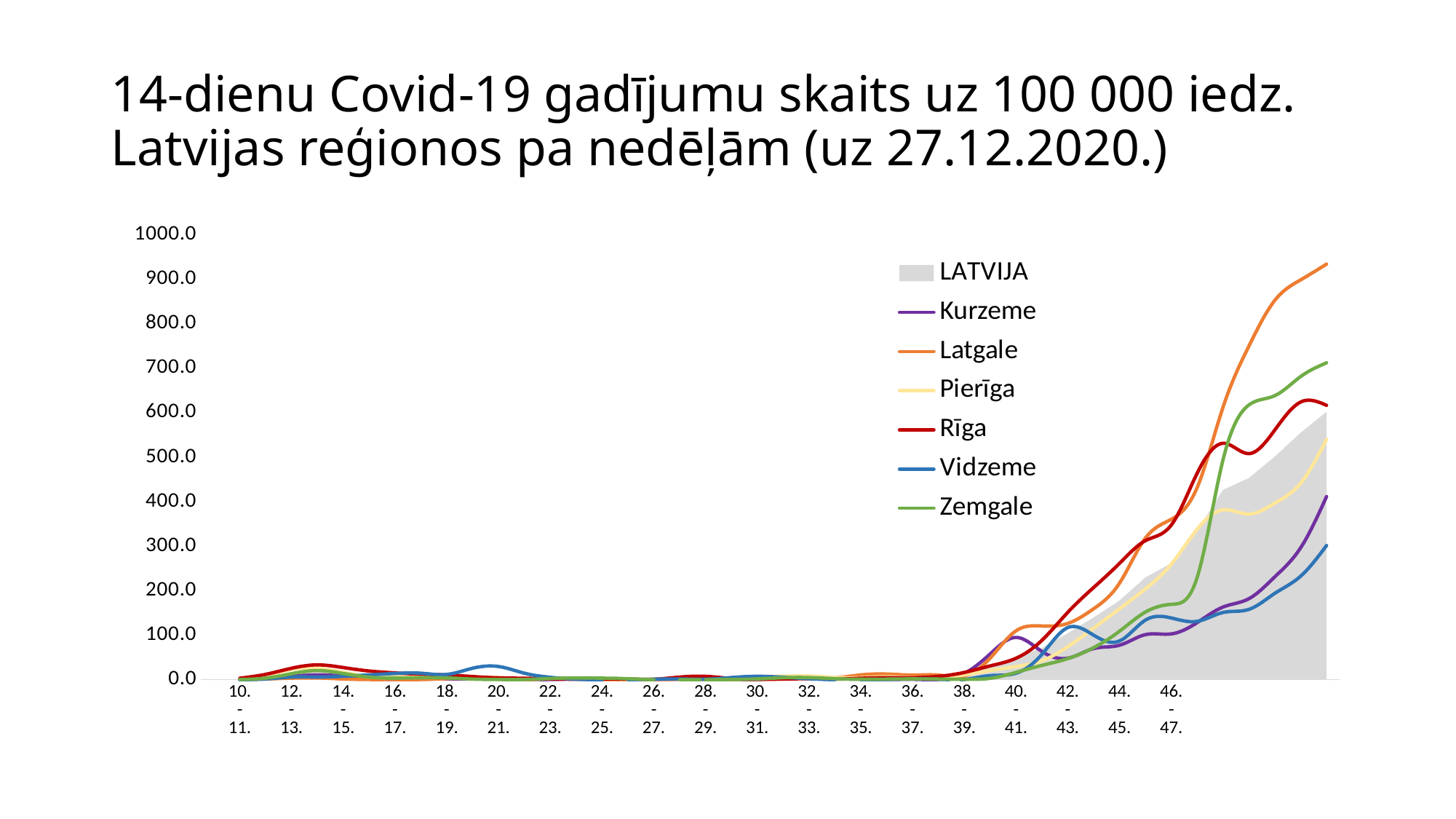
Do the values generally rise or fall along the x axis? rise At the right end of the chart, is the value for Latgale greater or less than 800? greater At the right end of the chart, which is larger: the value for Latgale or the value for Zemgale? Latgale How many series does the legend list? 7 Which legend entry is shown as a grey shaded area rather than a line? LATVIJA At the right end of the chart, is the value for Zemgale greater or less than 600? greater What kind of chart is shown on the slide? line chart At the right end of the chart, which is larger: the value for Rīga or the value for Vidzeme? Rīga At the right end of the chart, is the value for Vidzeme greater or less than 400? less Which region's line is lowest at the right end of the chart? Vidzeme Which region's line is highest at the right end of the chart? Latgale